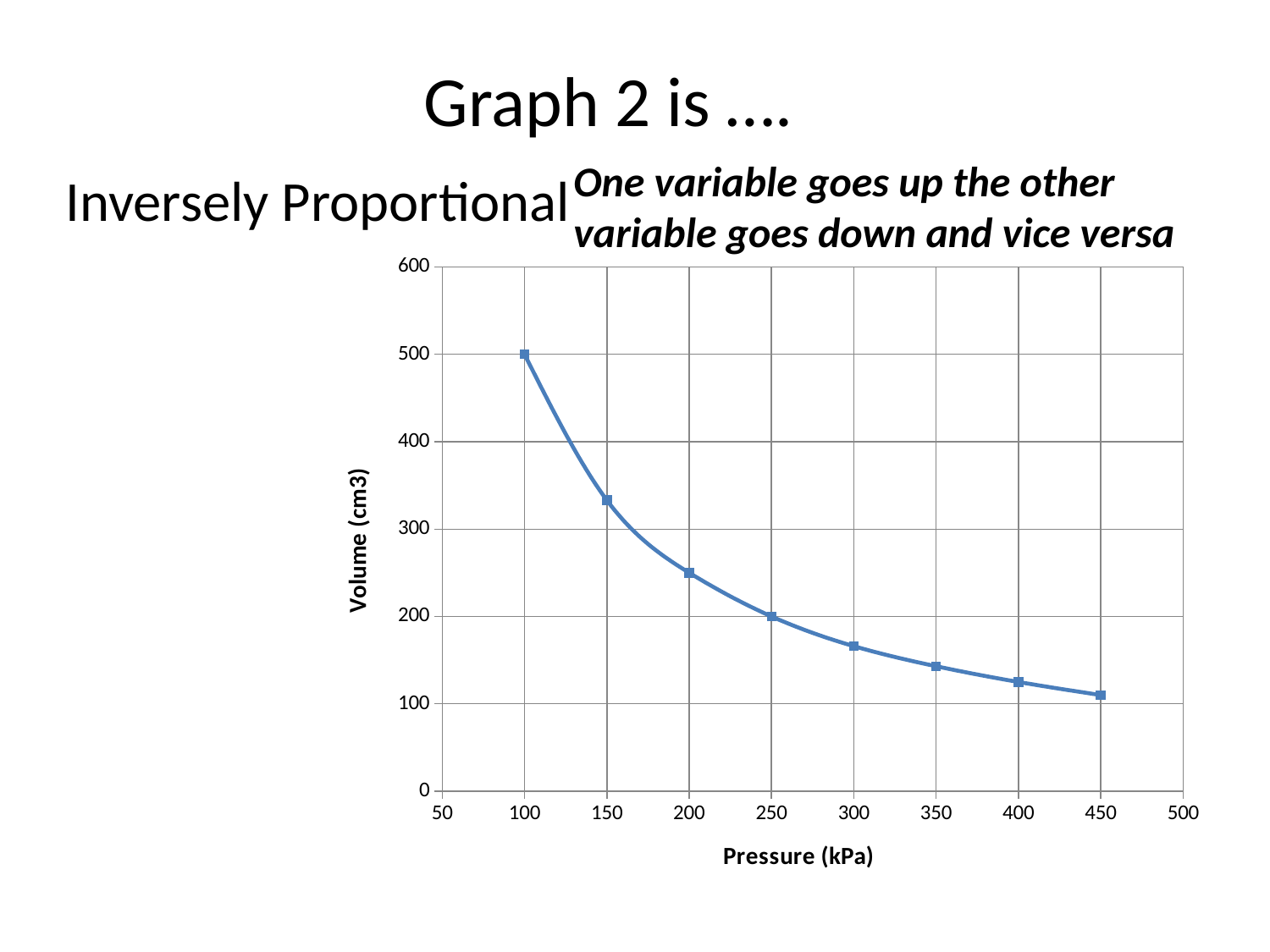
Which has the larger volume: 150 kPa or 350 kPa? 150 kPa What is the volume at a pressure of 100 kPa? 500 Is the volume at 300 kPa greater or less than 200? less Is the volume at 150 kPa greater or less than 300? greater How many data points are plotted on the chart? 8 At which pressure is the volume highest? 100 kPa What kind of chart is shown on the slide? line chart What is the volume at a pressure of 250 kPa? 200 What is the difference between the volume at 100 kPa and the volume at 250 kPa? 300 Does the volume rise or fall as pressure increases along the x axis? fall At which pressure is the volume lowest? 450 kPa Is the volume at 450 kPa greater or less than 100? greater